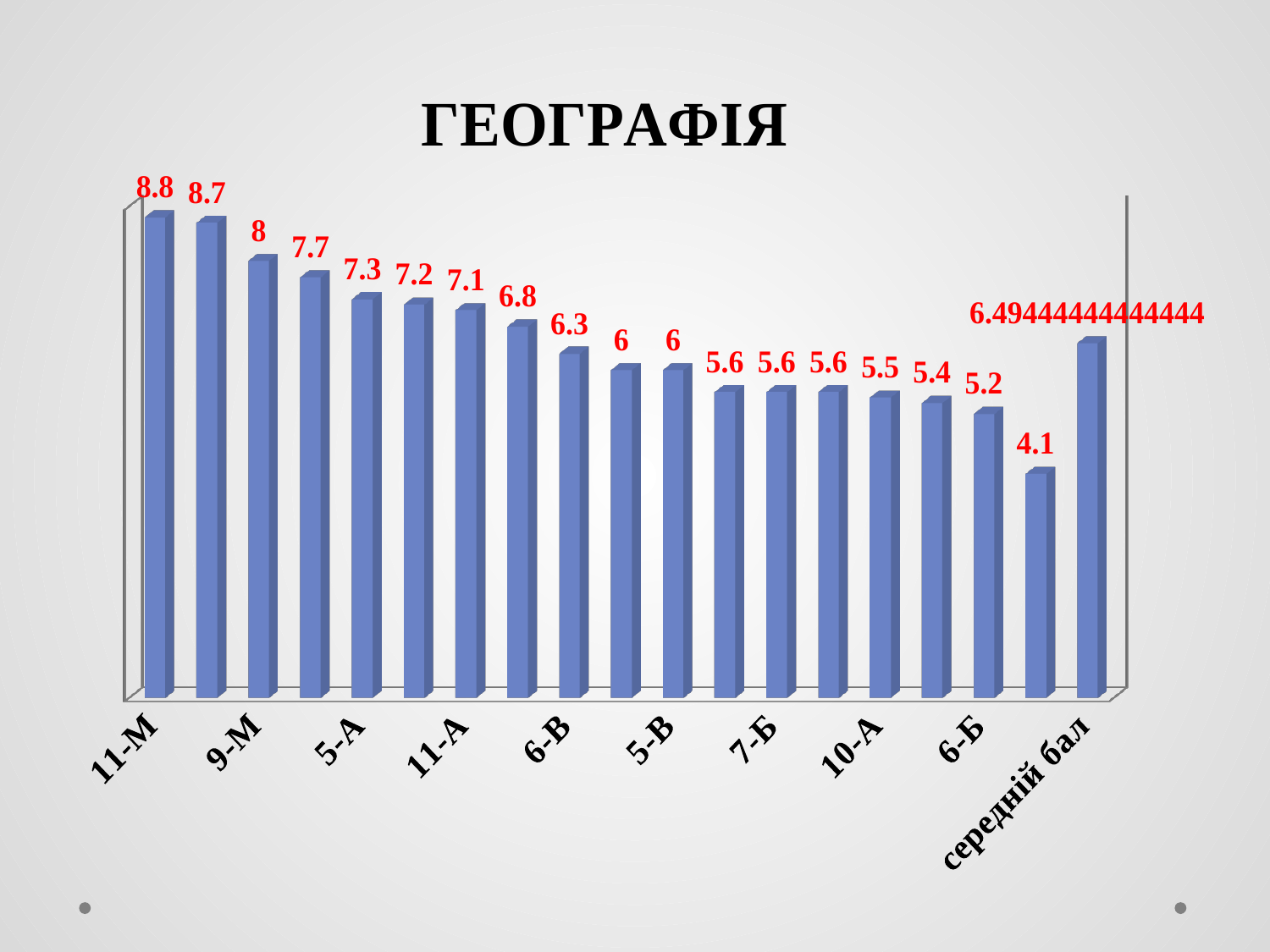
What is the title of the chart? ГЕОГРАФІЯ What kind of chart is shown? Bar chart What is the value for 6-Б? 5.2 What is the value shown for середній бал? 6.49444444444444 Which category has the highest value? 11-М What is the difference between the values for 11-М and 6-Б? 3.6 How many bars are plotted on the chart? 19 What is the value for 5-А? 7.3 Which is larger, the value for 5-А or the value for 11-А? 5-А What is the lowest value labelled on the chart? 4.1 What is the value for 11-М? 8.8 What is the value for 9-М? 8